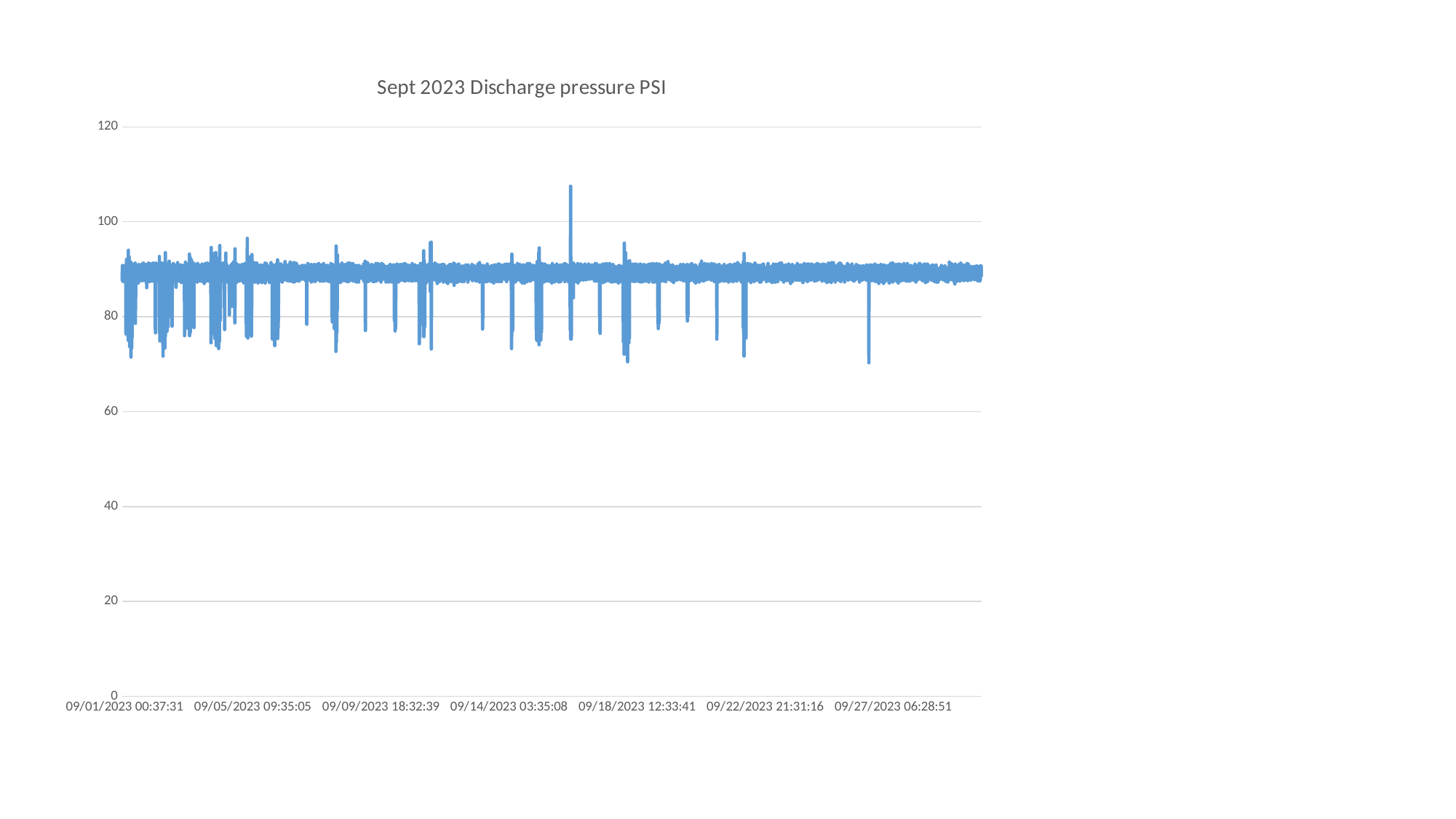
Is the lowest dip of the discharge pressure line greater or less than 80? less What is the first date label on the x axis? 09/01/2023 00:37:31 Is the highest peak of the discharge pressure line greater or less than 100? greater How many date labels are shown along the x axis? 7 Is the highest peak of the discharge pressure line greater or less than 120? less What is the maximum value shown on the y axis? 120 Overall, does the discharge pressure line rise, fall, or stay roughly flat across the month? stays roughly flat What is the title of the chart? Sept 2023 Discharge pressure PSI What kind of chart is shown on the slide? line chart